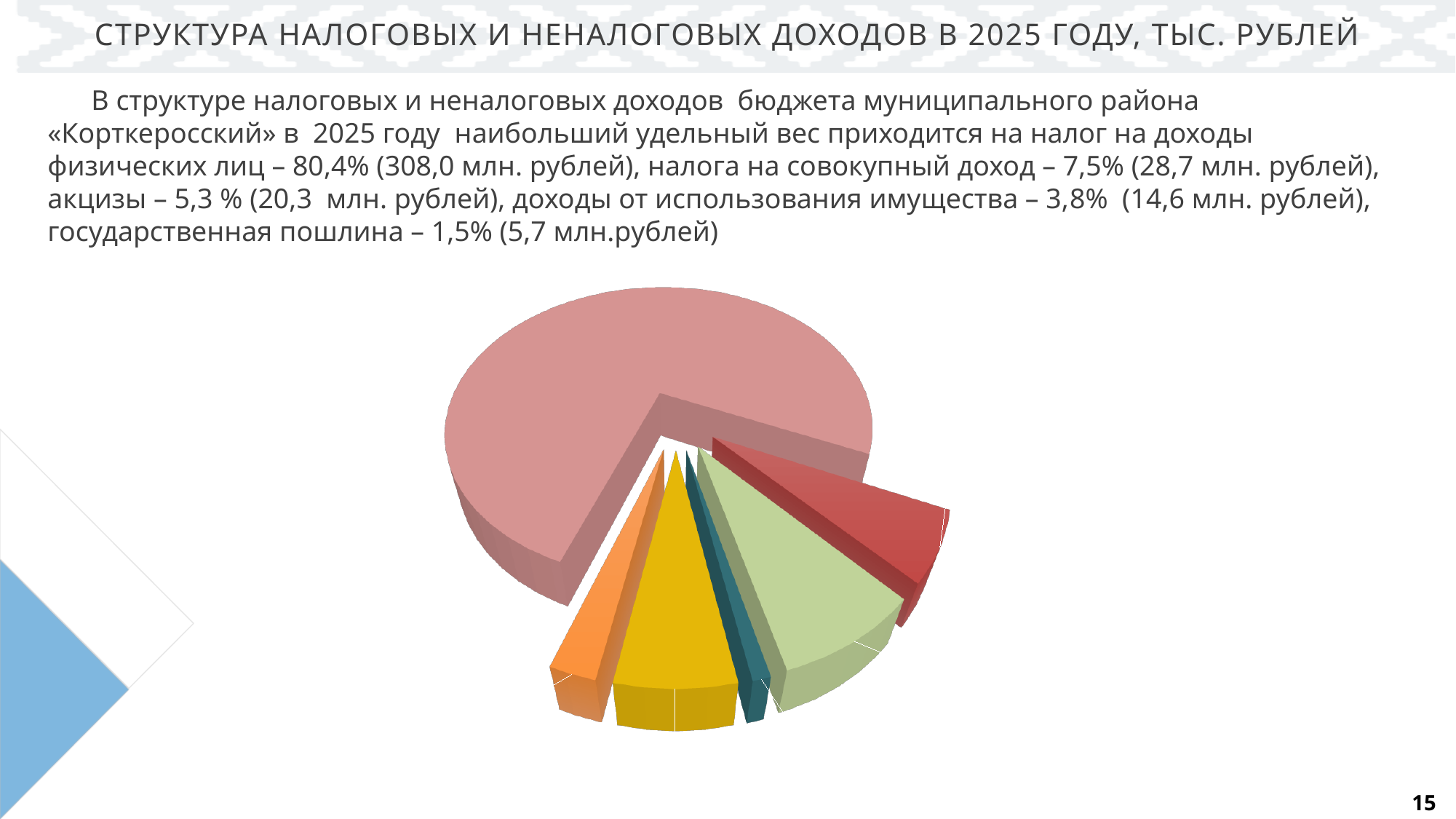
What colour is the largest slice of the pie chart? pink What kind of chart is shown on the slide? pie chart How many slices does the pie chart have? 6 Does the pie chart show data labels on its slices? No Does the pie chart display a legend? No